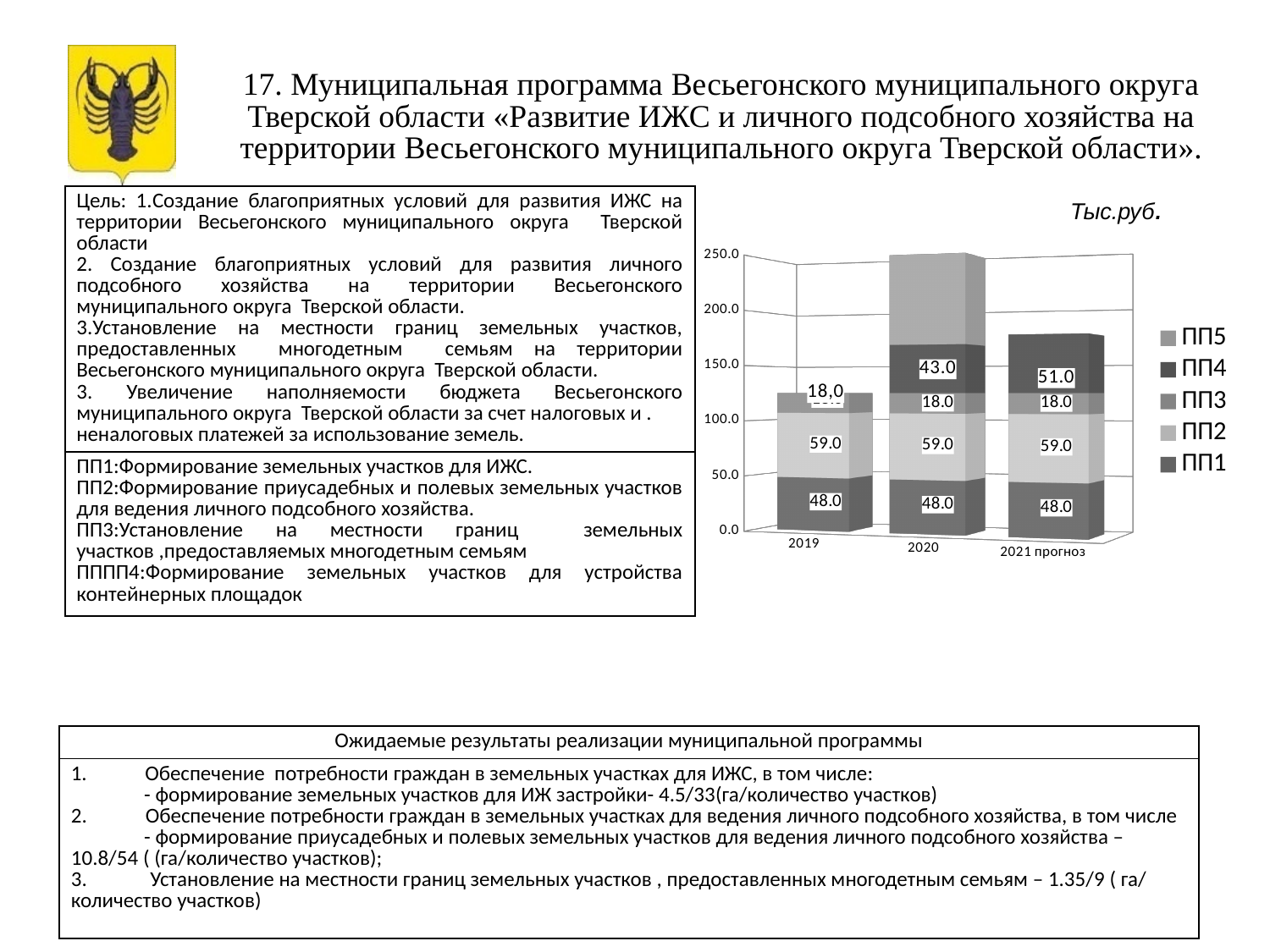
Is the total of the stacked bar for 2020 greater or less than 200.0? greater What is the value of ПП4 for 2021 прогноз? 51.0 What is the total of the stacked bar for 2021 прогноз? 176.0 What kind of chart is shown on the slide? Stacked bar chart Which year has the larger ПП4 value, 2020 or 2021 прогноз? 2021 прогноз What is the value of ПП2 for 2019? 59.0 What is the value of ПП4 for 2020? 43.0 What is the value of ПП1 for 2019? 48.0 How many categories (years) are shown on the x axis of the chart? 3 How many series does the chart legend list? 5 Which year has the tallest stacked bar? 2020 By how much does the ПП4 value for 2021 прогноз exceed the ПП4 value for 2020? 8.0